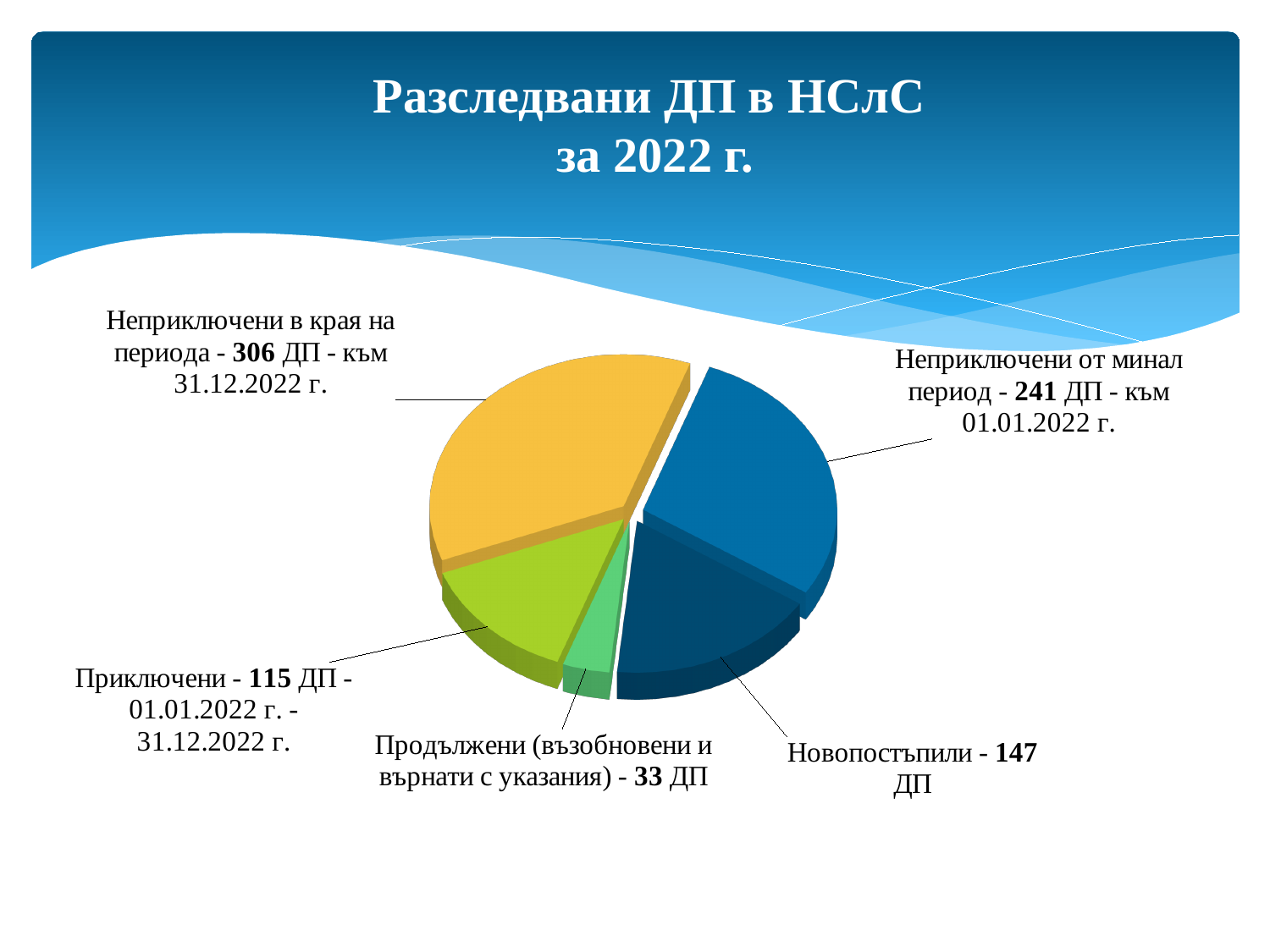
Which category has the largest value? Неприключени в края на периода (306 ДП) What is the value for Новопостъпили? 147 ДП What kind of chart is shown on the slide? pie chart How many slices does the pie chart have? 5 What is the difference between Неприключени в края на периода and Неприключени от минал период? 65 What is the value for Неприключени от минал период към 01.01.2022 г.? 241 ДП What is the value for Продължени (възобновени и върнати с указания)? 33 ДП What is the value for Приключени? 115 ДП Which is larger, Новопостъпили or Приключени? Новопостъпили What is the difference between Новопостъпили and Приключени? 32 What is the title of the chart? Разследвани ДП в НСлС за 2022 г. Which category has the smallest value? Продължени (възобновени и върнати с указания) (33 ДП)